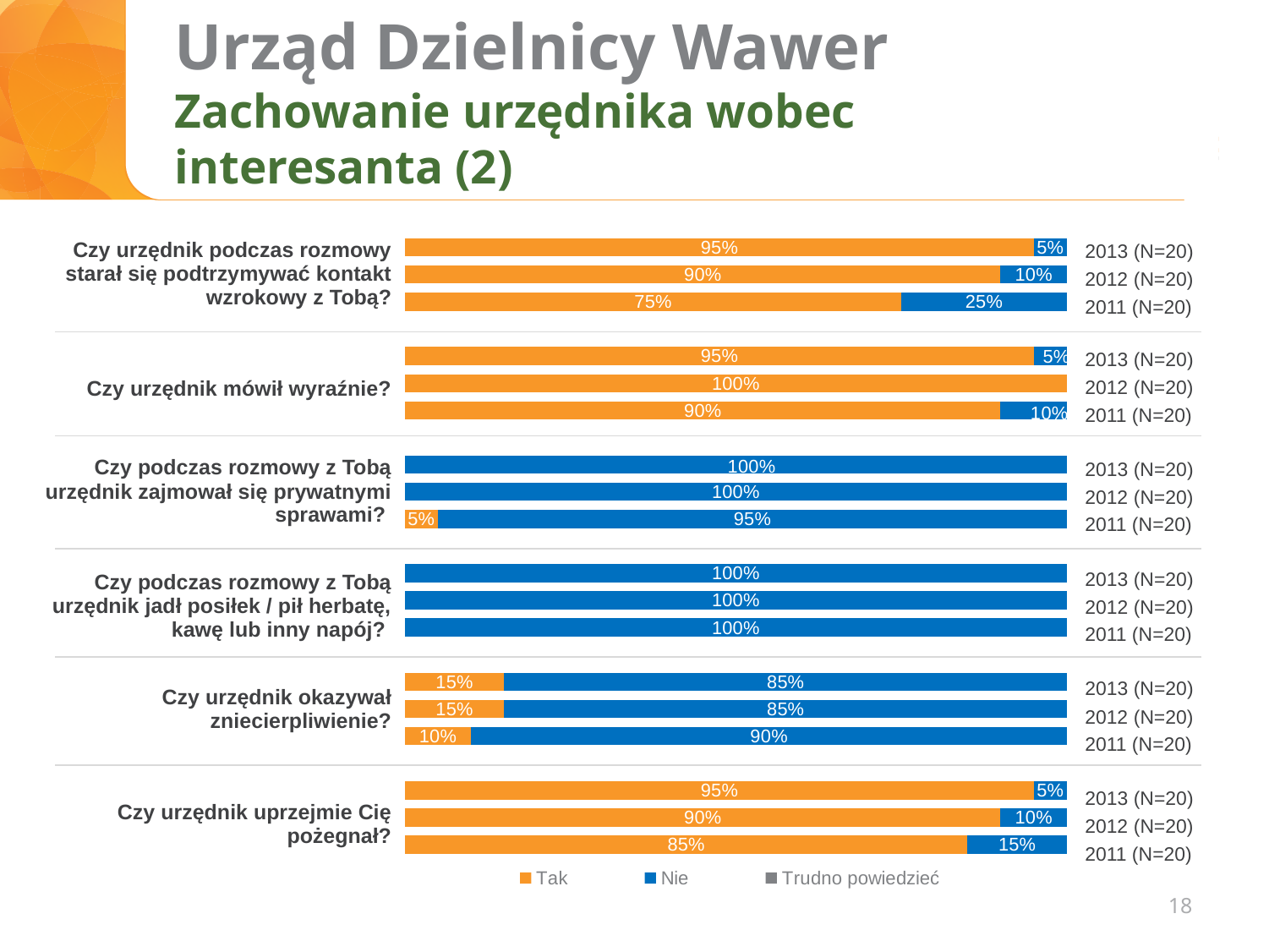
What percentage answered "Nie" in 2011 to "Czy urzędnik podczas rozmowy starał się podtrzymywać kontakt wzrokowy z Tobą?"? 25% For "Czy urzędnik podczas rozmowy starał się podtrzymywać kontakt wzrokowy z Tobą?", what is the difference in "Tak" share between 2013 and 2011? 20 percentage points For "Czy urzędnik podczas rozmowy starał się podtrzymywać kontakt wzrokowy z Tobą?", which year had the highest "Tak" share? 2013 (N=20) How many series does the legend list? 3 For "Czy urzędnik podczas rozmowy starał się podtrzymywać kontakt wzrokowy z Tobą?", does the "Tak" share rise or fall from 2011 to 2013? rise For "Czy urzędnik okazywał zniecierpliwienie?", is the "Tak" share in 2013 larger or smaller than in 2011? larger What percentage answered "Tak" in 2012 to "Czy urzędnik mówił wyraźnie?"? 100% What percentage answered "Tak" in 2011 to "Czy urzędnik uprzejmie Cię pożegnał?"? 85% For "Czy urzędnik uprzejmie Cię pożegnał?", which year had the lowest "Tak" share? 2011 (N=20) For "Czy urzędnik okazywał zniecierpliwienie?", what percentage answered "Nie" in 2011? 90% What percentage answered "Tak" in 2013 to "Czy urzędnik podczas rozmowy starał się podtrzymywać kontakt wzrokowy z Tobą?"? 95% What kind of chart is shown on the slide? stacked bar chart